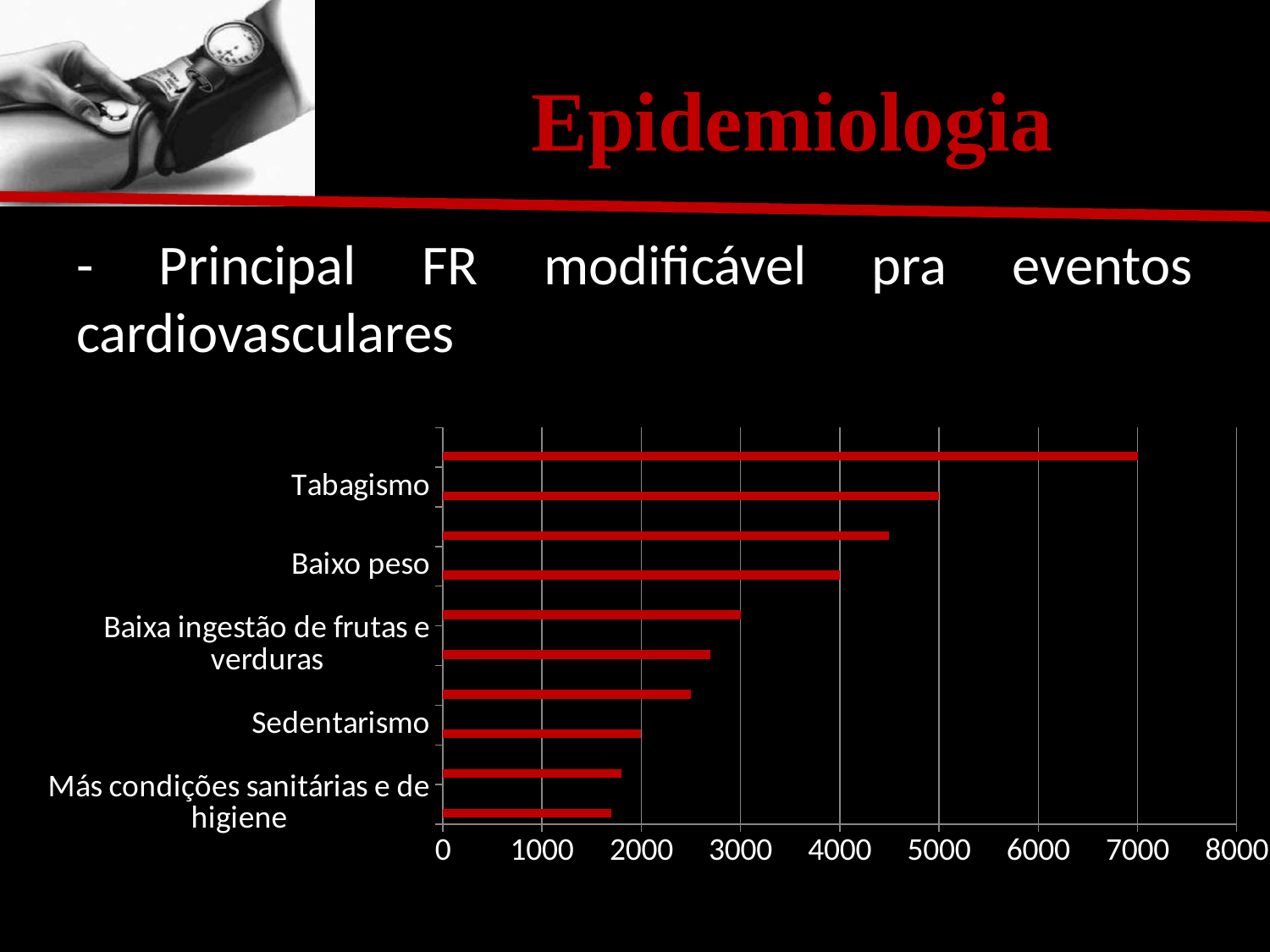
Which has a larger value, Tabagismo or Baixo peso? Tabagismo What is the maximum value shown on the horizontal axis? 8000 Is the value for Más condições sanitárias e de higiene greater or less than 2000? less Which of the labelled categories has the highest value? Tabagismo Which of the labelled categories has the lowest value? Más condições sanitárias e de higiene Is the value for Baixa ingestão de frutas e verduras greater or less than 3000? less Is the value for Sedentarismo greater or less than 3000? less Which has a larger value, Sedentarismo or Baixa ingestão de frutas e verduras? Baixa ingestão de frutas e verduras What kind of chart is shown on the slide? bar chart